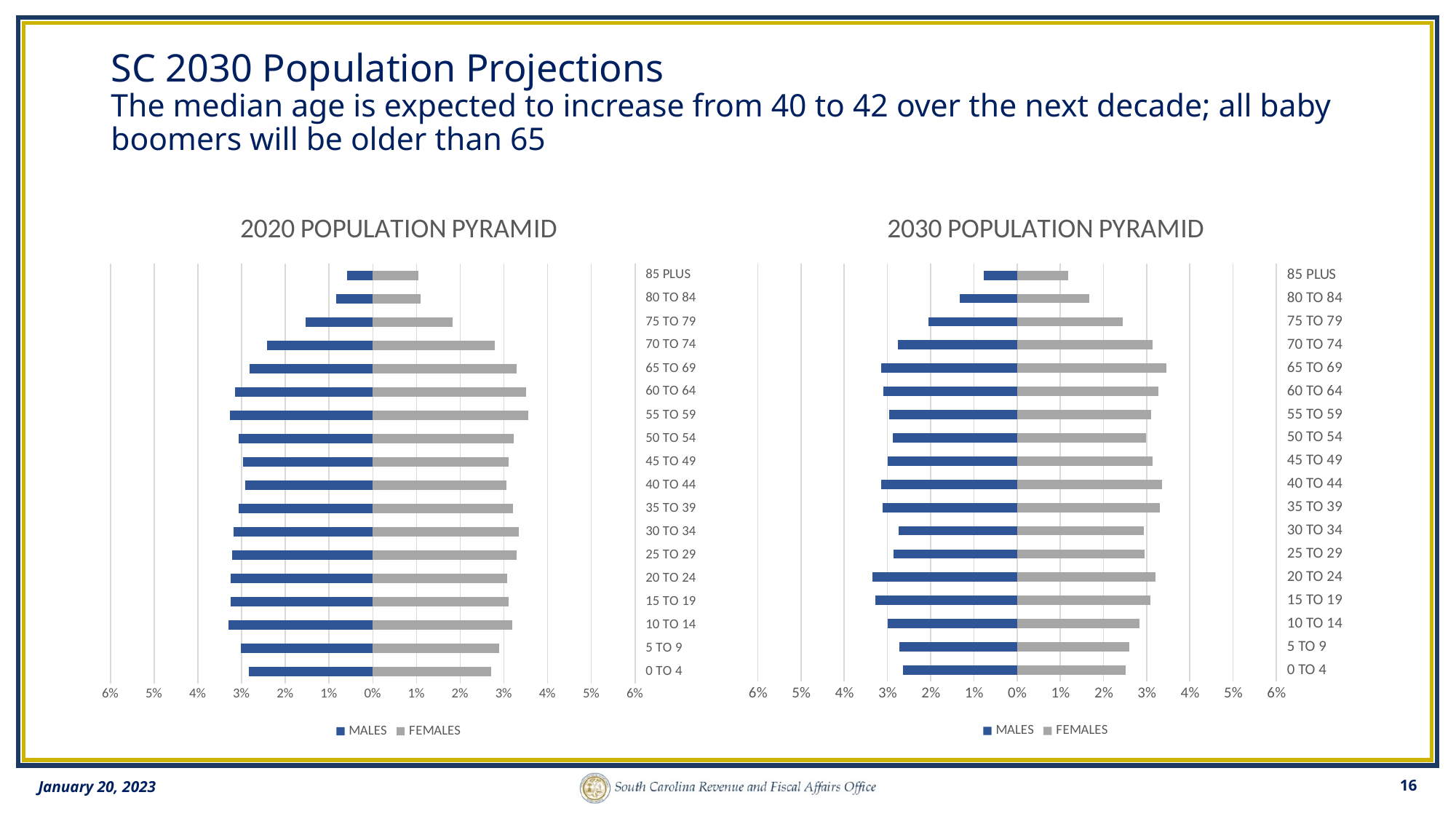
In the 2020 Population Pyramid, is the Females value for 75 to 79 greater or less than 1%? greater In the 2020 Population Pyramid, is the Males value for 70 to 74 greater or less than 2%? greater In the 2030 Population Pyramid, is the Females value for 80 to 84 greater or less than 1%? greater What kind of chart is the 2020 Population Pyramid? bar chart How many age groups are shown in the 2030 Population Pyramid? 18 In the 2030 Population Pyramid, which age group has the lowest Males value? 85 Plus In the 2030 Population Pyramid, which is larger for Males: 70 to 74 or 85 Plus? 70 to 74 In the 2020 Population Pyramid, which is larger for Females: 85 Plus or 75 to 79? 75 to 79 In the 2030 Population Pyramid, which colour represents Females? gray How many series does the legend of the 2020 Population Pyramid list? 2